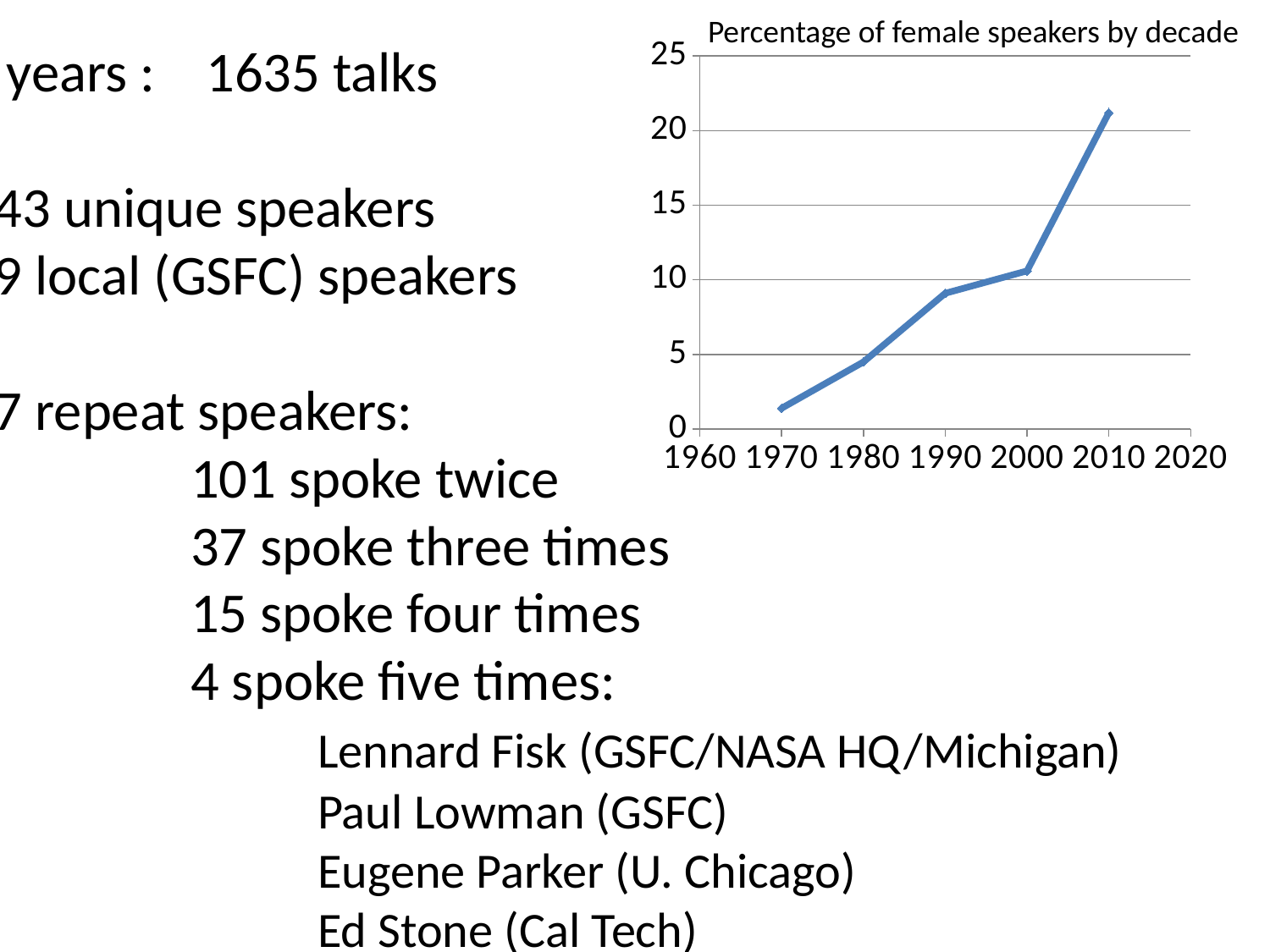
Which decade has the highest percentage of female speakers? 2010 Which is larger, the value for 1970 or the value for 1980? 1980 Is the value for 2000 greater or less than 15? less What is the title of the chart? Percentage of female speakers by decade Does the percentage of female speakers rise or fall from 1970 to 2010? rise Which decade has the lowest percentage of female speakers? 1970 What kind of chart is shown on the slide? line chart Is the value for 1970 greater or less than 5? less Which is larger, the value for 2000 or the value for 2010? 2010 Is the value for 2010 greater or less than 20? greater How many data points are plotted on the line? 5